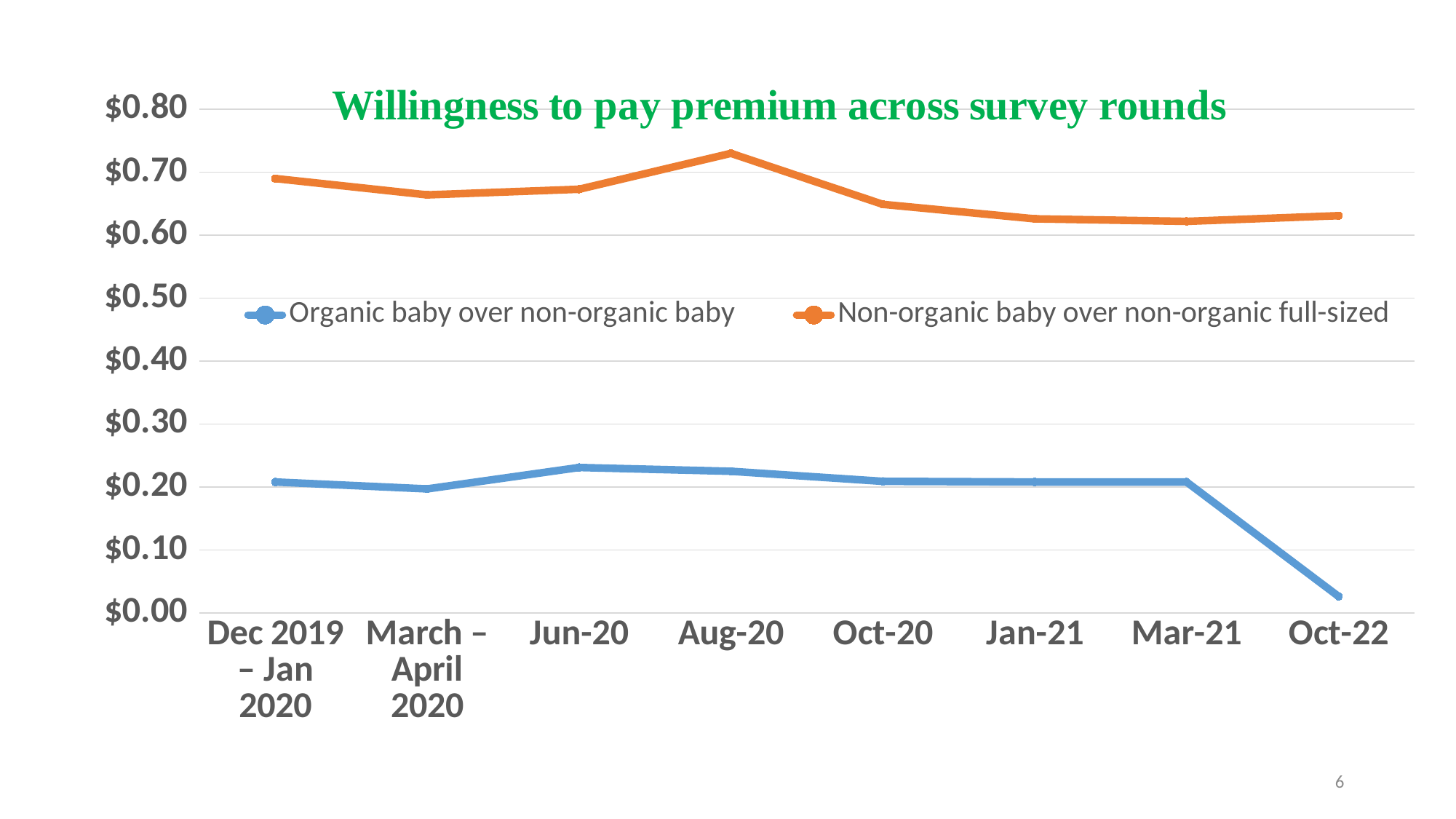
Is the value for Non-organic baby over non-organic full-sized in Aug-20 greater or less than $0.70? greater Is the value for Organic baby over non-organic baby in Oct-22 greater or less than $0.10? less In which survey round is the Organic baby over non-organic baby premium lowest? Oct-22 What kind of chart is shown on the slide? Line chart In which survey round is the Non-organic baby over non-organic full-sized premium highest? Aug-20 Is the value for Non-organic baby over non-organic full-sized in Oct-20 greater or less than $0.70? less Does the Organic baby over non-organic baby premium rise or fall between Mar-21 and Oct-22? Fall What is the title of the chart? Willingness to pay premium across survey rounds In Jan-21, which series has the larger value: Organic baby over non-organic baby or Non-organic baby over non-organic full-sized? Non-organic baby over non-organic full-sized How many series does the legend list? 2 How many survey rounds are plotted along the x axis? 8